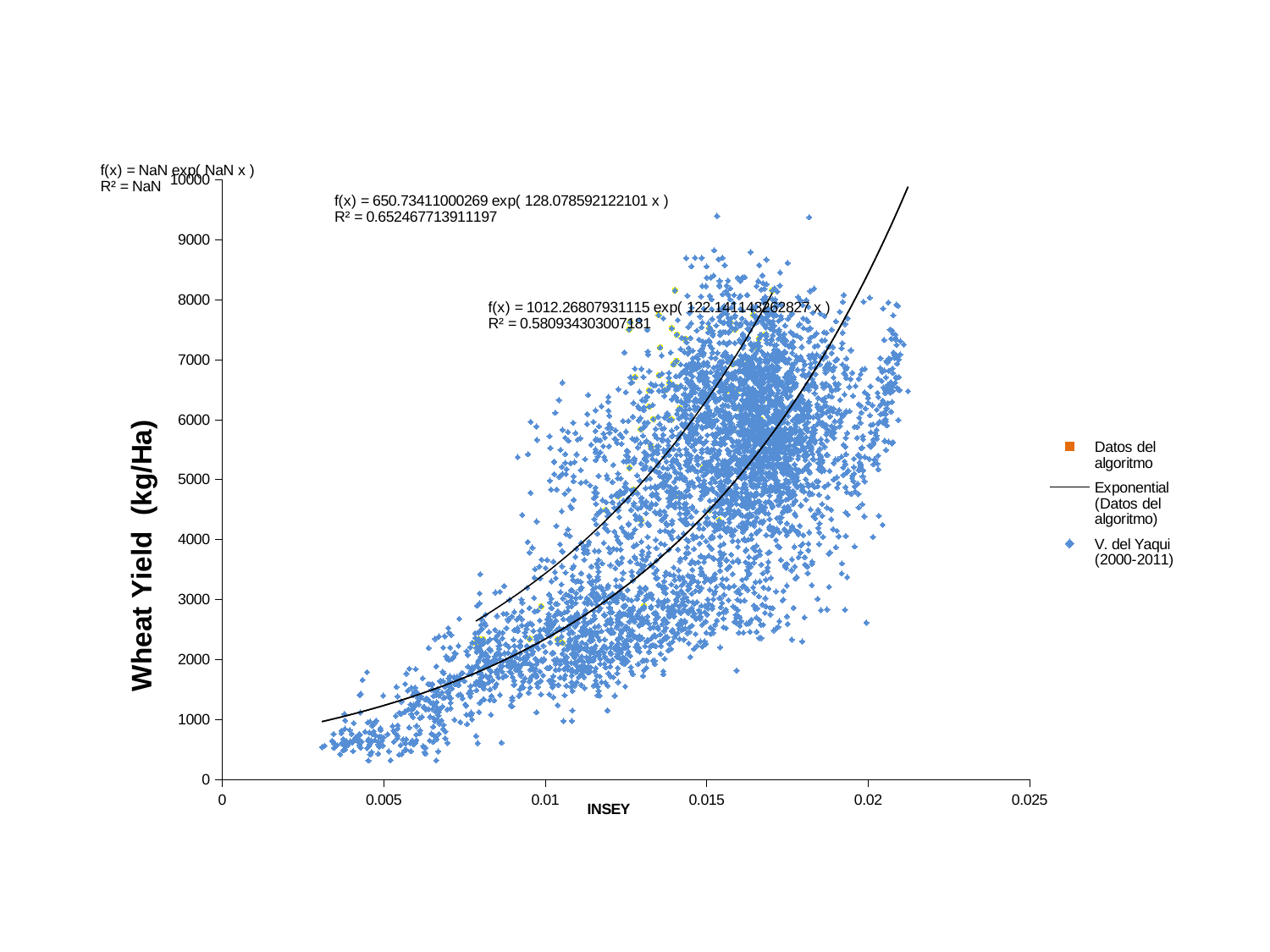
What kind of chart is shown on the slide? Scatter chart What is the highest tick value shown on the y axis? 10000 What R² value is printed for the trendline with the equation f(x) = 650.73411000269 exp( 128.078592122101 x )? 0.652467713911197 What is the label of the x axis? INSEY Do the Wheat Yield values generally rise or fall as INSEY increases along the x axis? Rise What R² value is printed for the trendline with the equation f(x) = 1012.26807931115 exp( 122.141143262827 x )? 0.580934303007181 What is the highest tick value shown on the x axis? 0.025 What is the label of the y axis? Wheat Yield (kg/Ha) How many entries does the legend list? 3 Which of the two printed R² values is larger, 0.652467713911197 or 0.580934303007181? 0.652467713911197